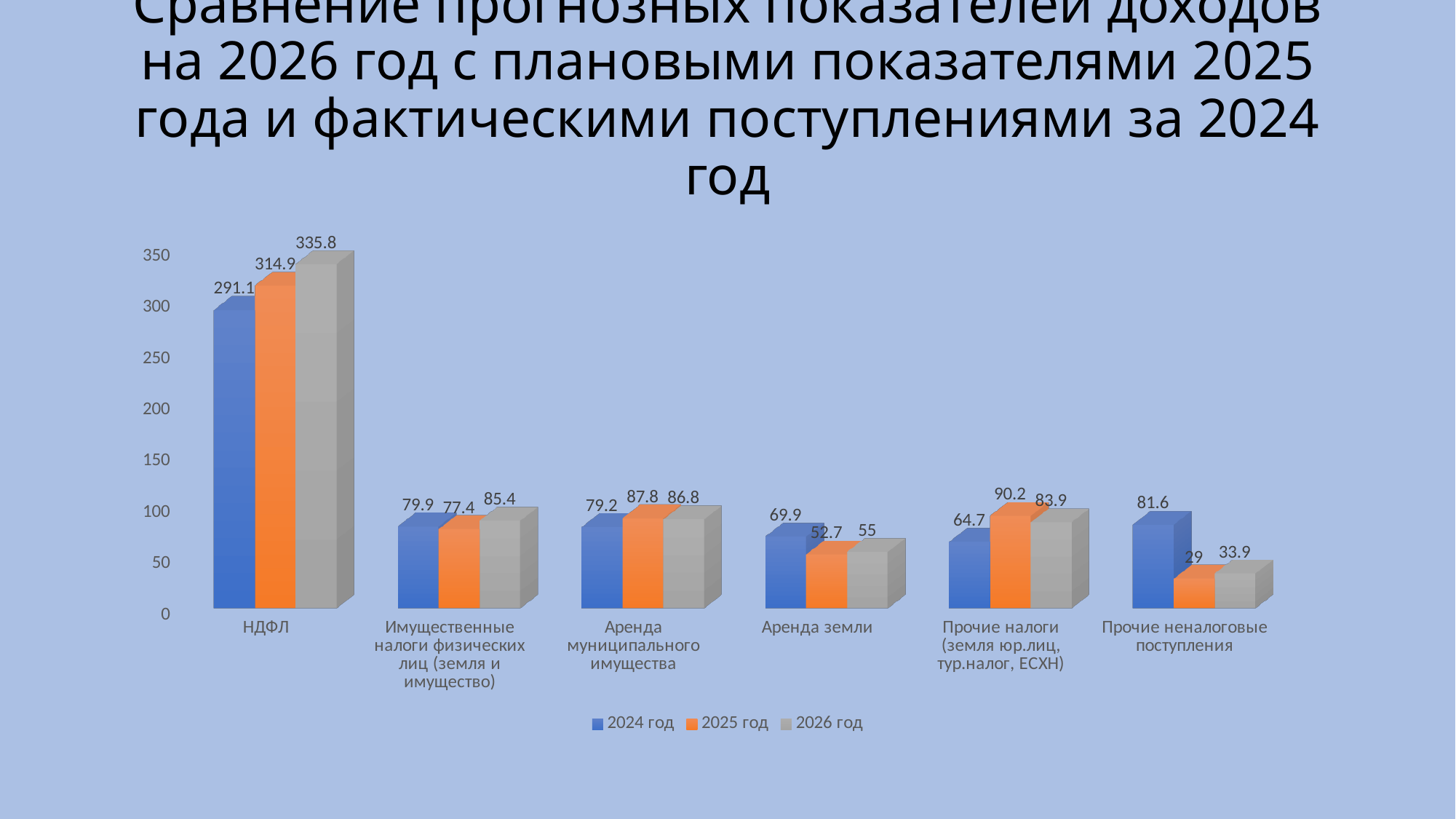
Is the value for Прочие налоги (земля юр.лиц, тур.налог, ЕСХН) in the 2026 год series greater or less than 100? less How many series does the legend list? 3 How many categories are shown on the x axis? 6 What kind of chart is shown on the slide? bar chart What is the value for Аренда земли in the 2025 год series? 52.7 Which category has the lowest value in the 2025 год series? Прочие неналоговые поступления What is the difference between the 2026 год and 2024 год values for НДФЛ? 44.7 What is the value for НДФЛ in the 2026 год series? 335.8 Which is larger for Аренда муниципального имущества: the 2025 год value or the 2024 год value? 2025 год What is the value for Прочие неналоговые поступления in the 2024 год series? 81.6 Which category has the highest value in the 2024 год series? НДФЛ Which colour represents the 2025 год series in the legend? orange